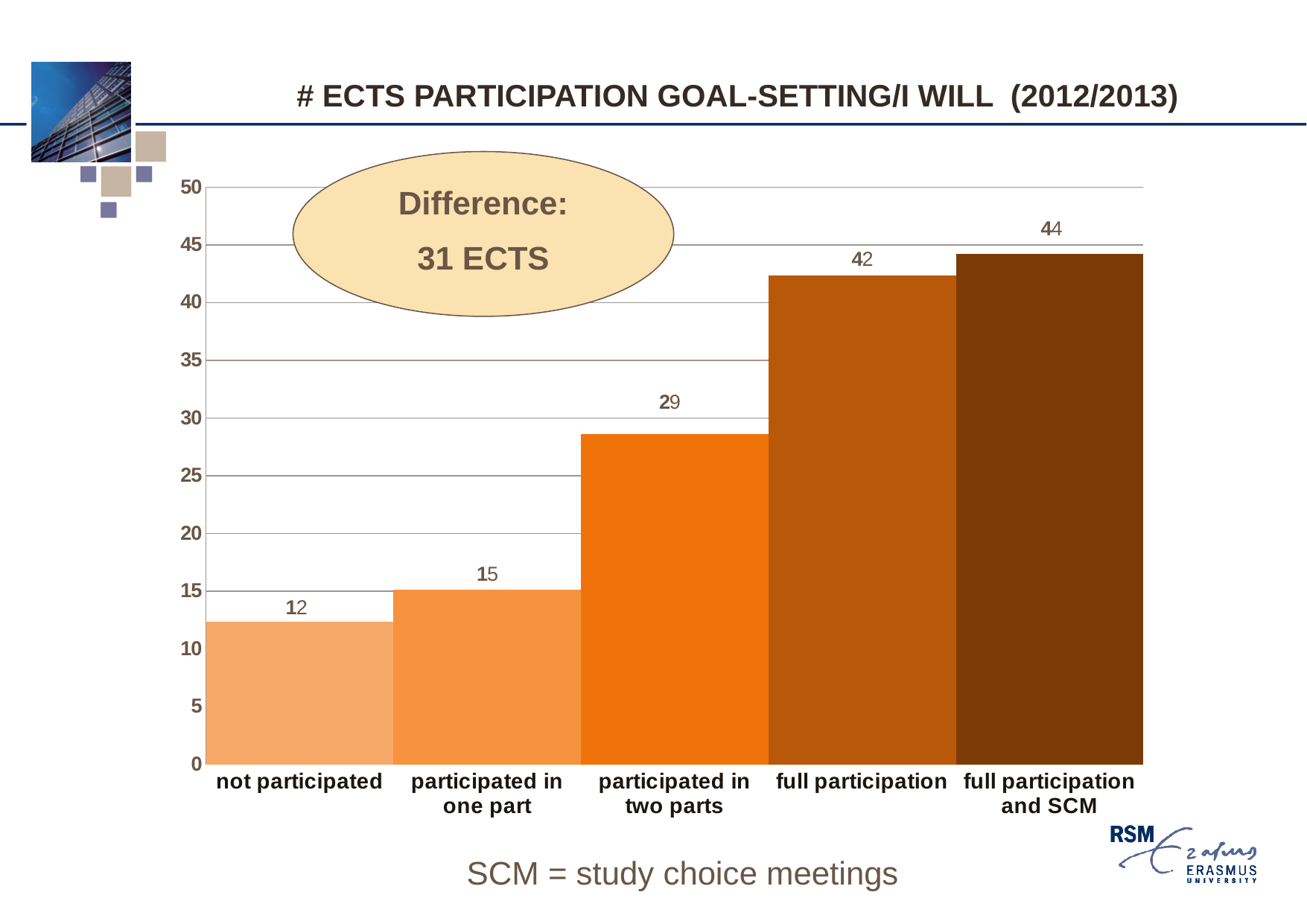
What is the difference between 'full participation and SCM' and 'not participated'? 32 What is the value for 'not participated'? 12 Do the values rise or fall from left to right along the x axis? rise What kind of chart is shown on the slide? bar chart How many categories are shown on the x axis? 5 Which is larger, 'participated in one part' or 'participated in two parts'? participated in two parts What is the value for 'full participation and SCM'? 44 Which category has the lowest value? not participated What is the difference between 'full participation' and 'participated in two parts'? 13 Which category has the highest value? full participation and SCM What is the value for 'participated in two parts'? 29 Is the value for 'full participation' greater or less than 40? greater